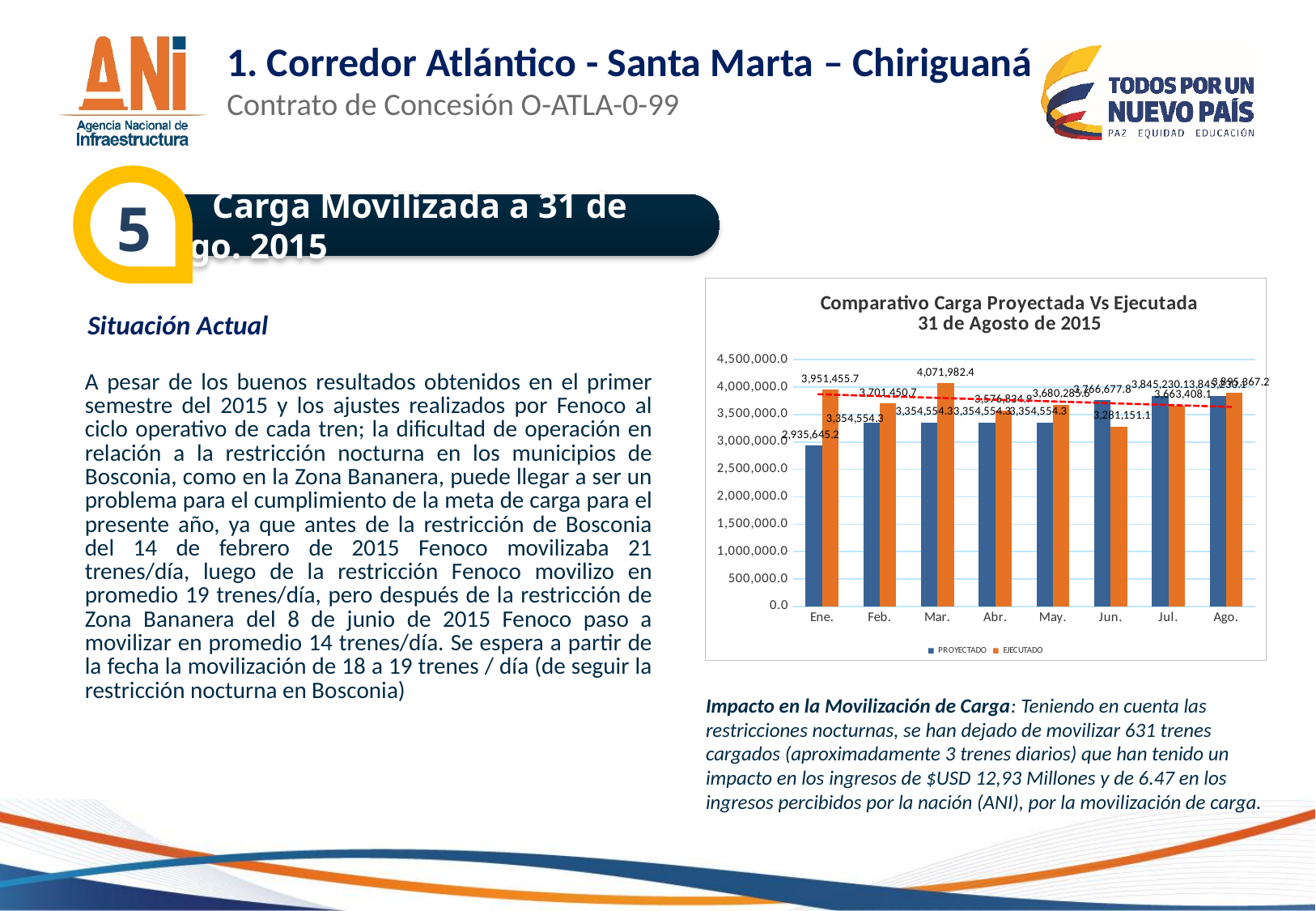
In which month is the PROYECTADO value lowest? Ene. In Ene., which is larger, PROYECTADO or EJECUTADO? EJECUTADO How many months are shown on the x axis of the chart? 8 What is the EJECUTADO value for Mar.? 4,071,982.4 What is the difference between the EJECUTADO and PROYECTADO values for Ene.? 1,015,810.5 Is the EJECUTADO value for Mar. greater or less than 4,000,000.0? greater What is the PROYECTADO value for Ene.? 2,935,645.2 How many series does the chart legend list? 2 What kind of chart is shown on the slide? Bar chart In which month is the EJECUTADO value highest? Mar. What is the EJECUTADO value for Feb.? 3,701,450.7 What is the EJECUTADO value for Ene.? 3,951,455.7